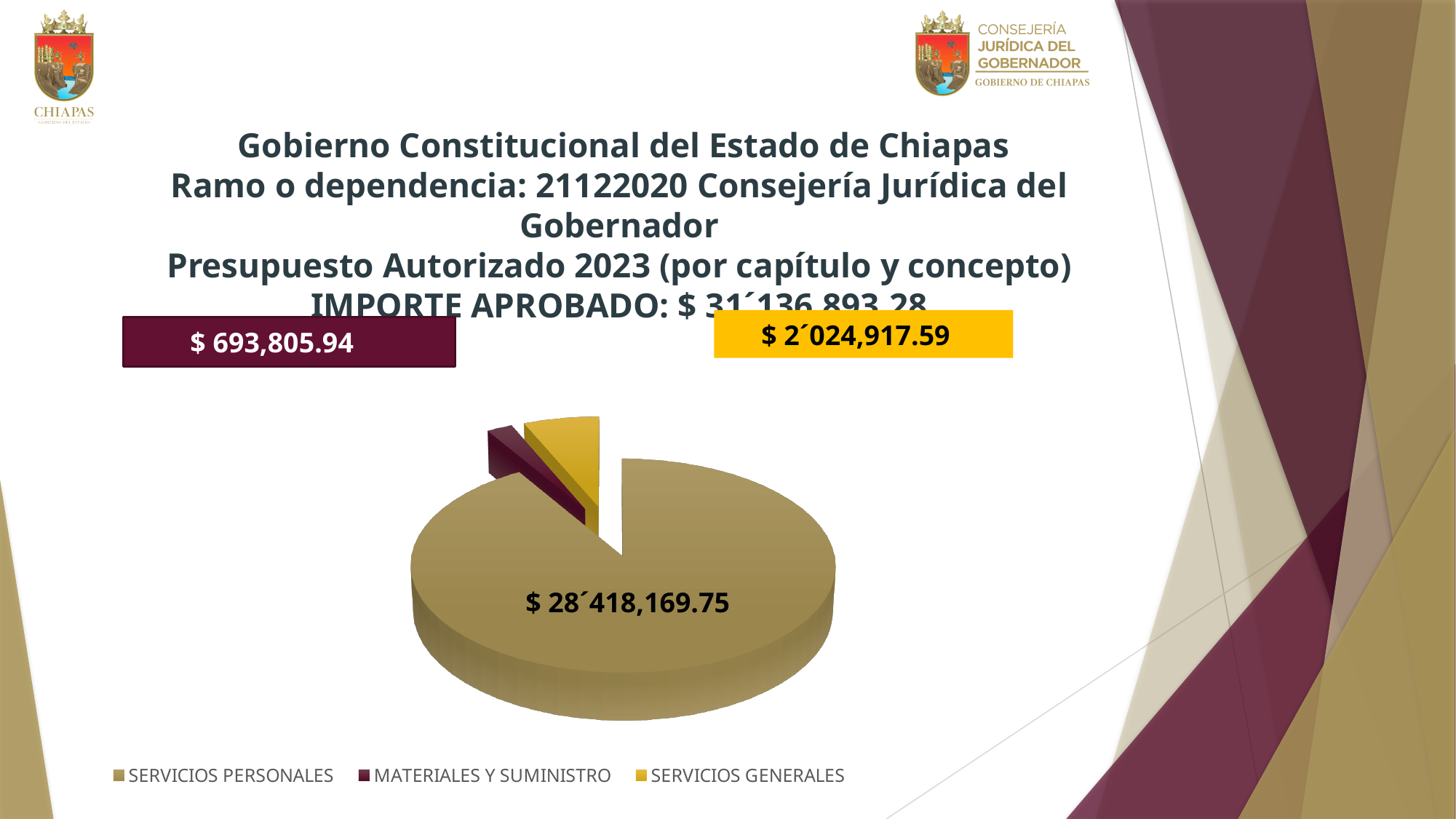
What kind of chart is shown on the slide? Pie chart Which category has the smallest slice of the pie chart? MATERIALES Y SUMINISTRO What is the value shown for SERVICIOS GENERALES in the pie chart? $ 2´024,917.59 How many entries does the legend list? 3 What is the value shown for SERVICIOS PERSONALES in the pie chart? $ 28´418,169.75 Which is larger, SERVICIOS GENERALES or MATERIALES Y SUMINISTRO? SERVICIOS GENERALES What is the value shown for MATERIALES Y SUMINISTRO in the pie chart? $ 693,805.94 Which category has the largest slice of the pie chart? SERVICIOS PERSONALES What colour represents MATERIALES Y SUMINISTRO in the pie chart? Maroon (dark red) How many slices does the pie chart have? 3 What is the difference between the values for SERVICIOS GENERALES and MATERIALES Y SUMINISTRO? $ 1´331,111.65 What is the total of the three values shown in the pie chart? $ 31´136,893.28